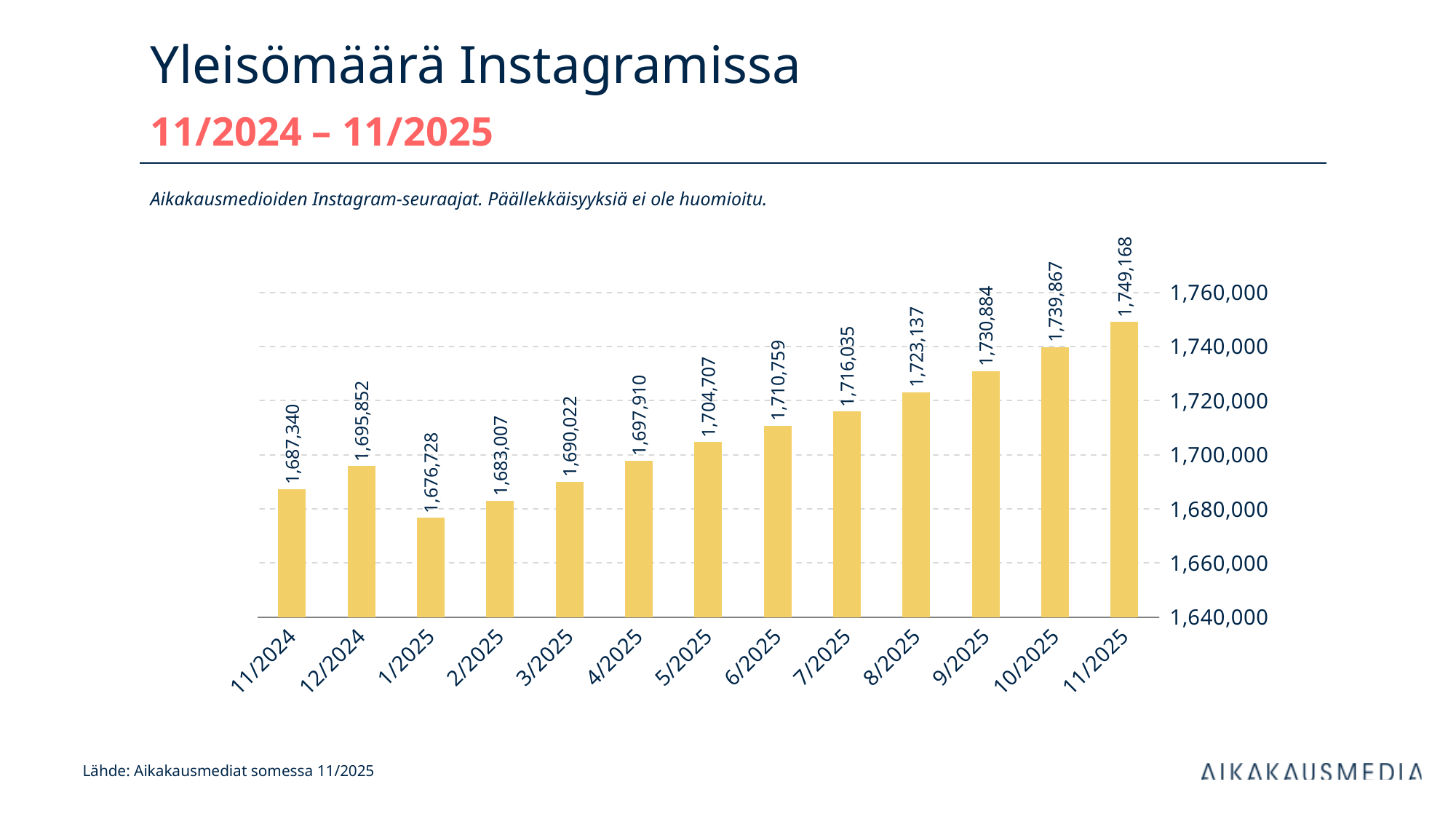
What is the difference between the values for 11/2025 and 11/2024? 61,828 Which month has the highest value? 11/2025 What kind of chart is shown on the slide? Bar chart Is the value for 9/2025 greater or less than 1,720,000? greater Do the values generally rise or fall from 1/2025 to 11/2025? Rise What is the value for 6/2025? 1,710,759 Which month has the lowest value? 1/2025 How many months are shown on the chart? 13 Which is larger, the value for 12/2024 or the value for 2/2025? 12/2024 What is the value for 11/2025? 1,749,168 What is the difference between the values for 12/2024 and 1/2025? 19,124 What is the value for 1/2025? 1,676,728